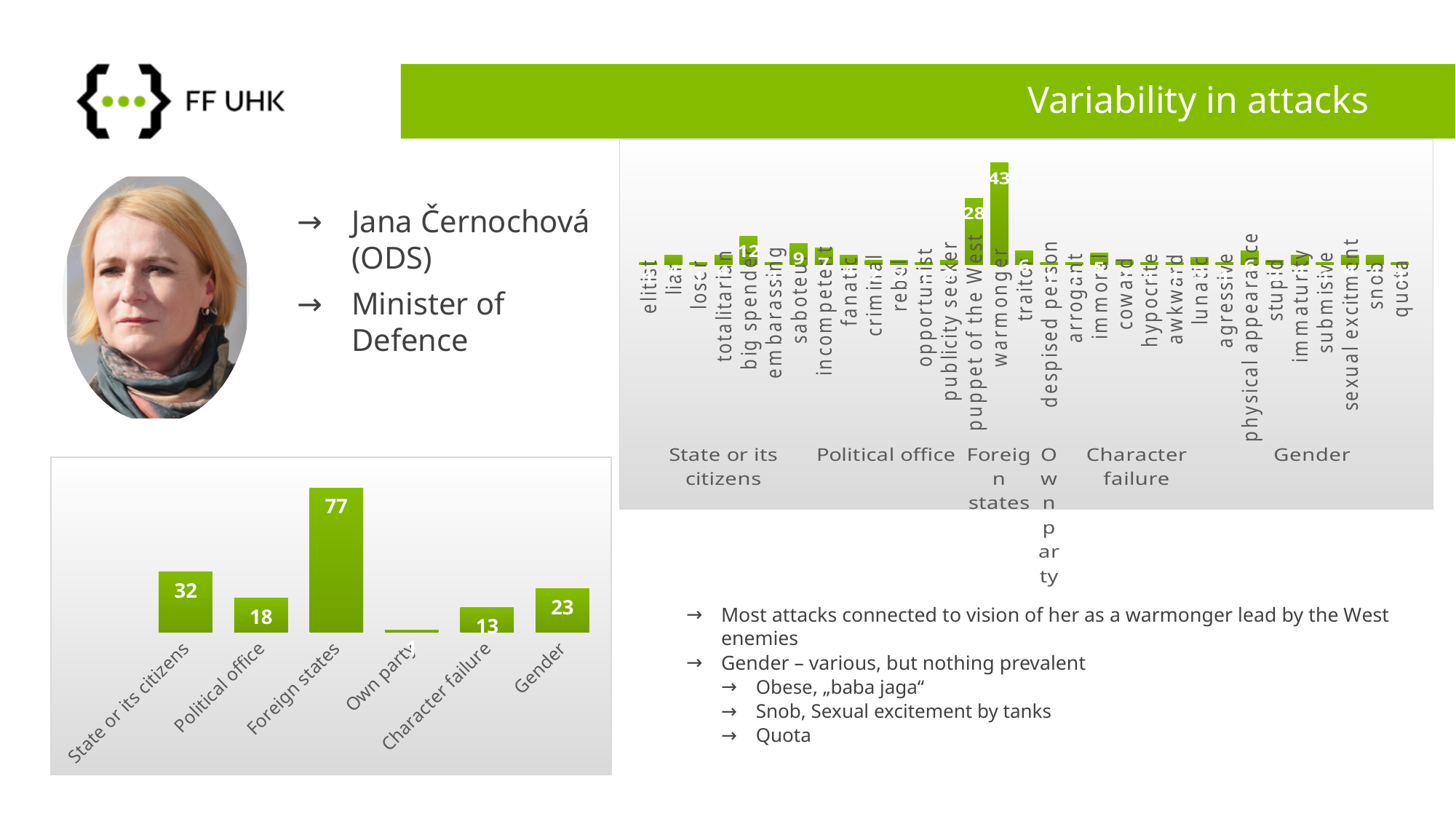
In the bottom-left chart, what is the value for Foreign states? 77 In the bottom-left chart, which category has the highest value? Foreign states In the bottom-left chart, which is larger: Political office or Character failure? Political office In the right-hand chart, what is the value for puppet of the West? 28 In the bottom-left chart, which category has the lowest value? Own party What type of chart is the bottom-left chart? bar chart In the bottom-left chart, what is the difference between Foreign states and State or its citizens? 45 In the bottom-left chart, what is the value for Gender? 23 In the right-hand chart, what is the difference between warmonger and puppet of the West? 15 In the right-hand chart, what is the value for warmonger? 43 In the bottom-left chart, what is the value for State or its citizens? 32 How many categories are shown in the bottom-left chart? 6